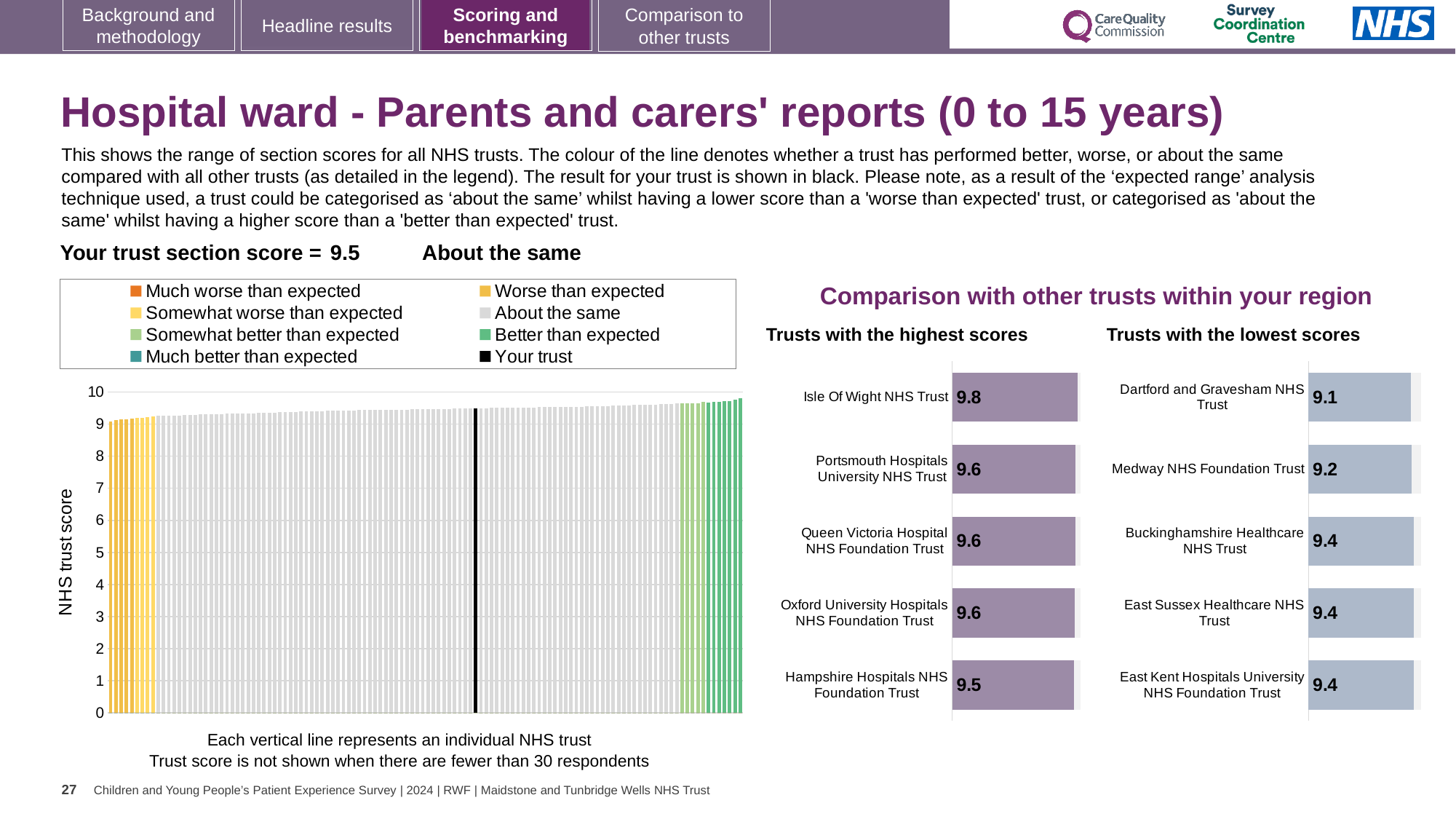
In the 'Trusts with the highest scores' chart, what is the score for Isle Of Wight NHS Trust? 9.8 In the 'Trusts with the highest scores' chart, what is the difference between the scores of Isle Of Wight NHS Trust and Hampshire Hospitals NHS Foundation Trust? 0.3 How many trusts are listed in the 'Trusts with the lowest scores' chart? 5 In the 'Trusts with the lowest scores' chart, what is the difference between the scores of Medway NHS Foundation Trust and Dartford and Gravesham NHS Trust? 0.1 In the large chart on the left, do the trust scores rise or fall from left to right? Rise In the 'Trusts with the lowest scores' chart, which trust has the lowest score? Dartford and Gravesham NHS Trust What kind of chart is the large chart on the left showing all NHS trusts? Bar chart How many entries does the legend above the large chart on the left list? 8 In the 'Trusts with the highest scores' chart, which trust has the highest score? Isle Of Wight NHS Trust How many trusts are listed in the 'Trusts with the highest scores' chart? 5 In the 'Trusts with the highest scores' chart, which has the higher score: Portsmouth Hospitals University NHS Trust or Hampshire Hospitals NHS Foundation Trust? Portsmouth Hospitals University NHS Trust In the 'Trusts with the lowest scores' chart, what is the score for Dartford and Gravesham NHS Trust? 9.1